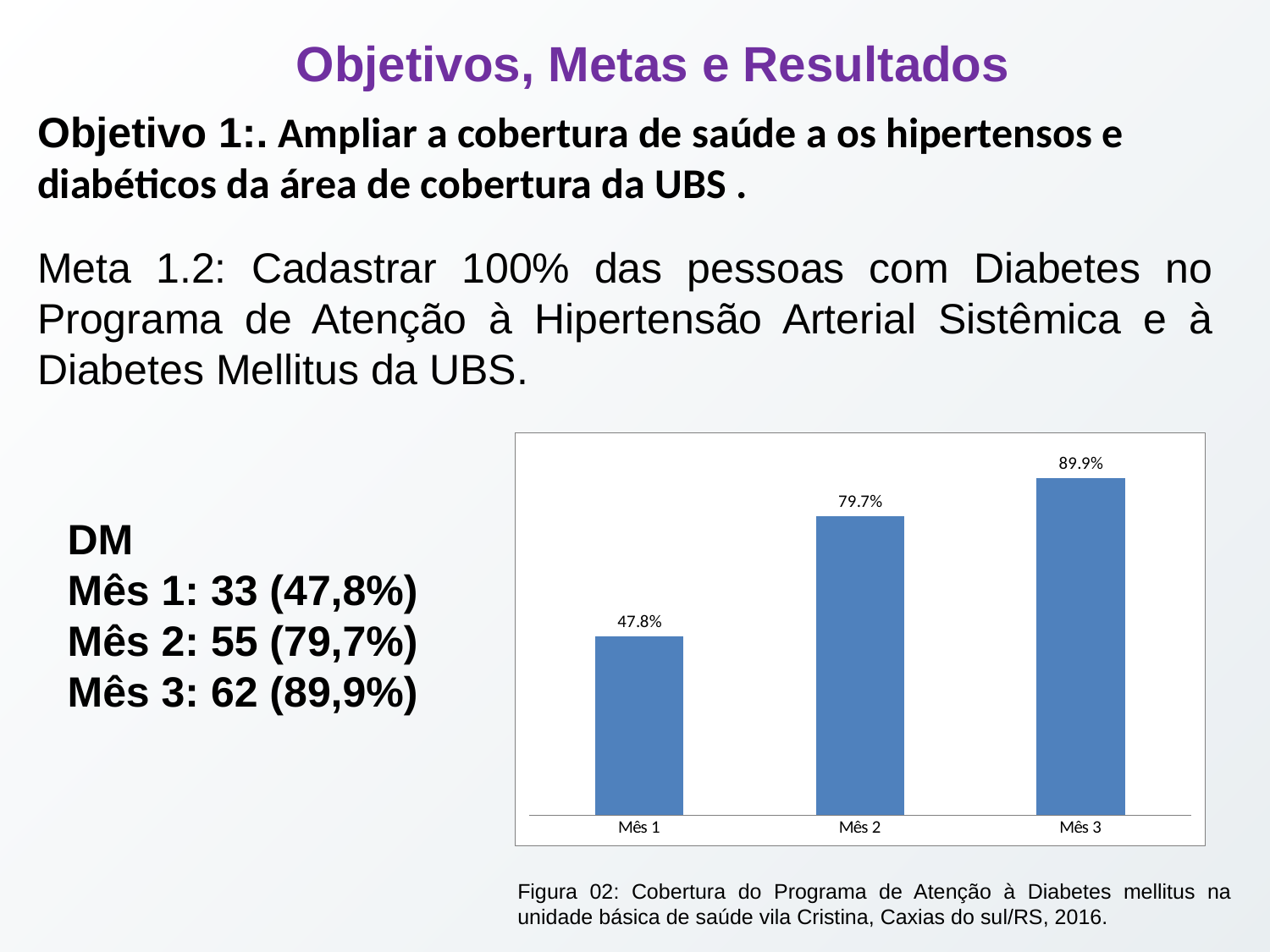
How many bars are shown in the chart? 3 What kind of chart is shown on the slide? Bar chart What is the difference between the values for Mês 2 and Mês 1? 31.9% What is the value for Mês 2 in the chart? 79.7% What is the value for Mês 3 in the chart? 89.9% Which month has the lowest value in the chart? Mês 1 What colour are the bars in the chart? Blue Which is larger, the value for Mês 2 or the value for Mês 3? Mês 3 Which month has the highest value in the chart? Mês 3 What is the value for Mês 1 in the chart? 47.8% Do the values rise or fall from Mês 1 to Mês 3? Rise What is the difference between the values for Mês 3 and Mês 1? 42.1%